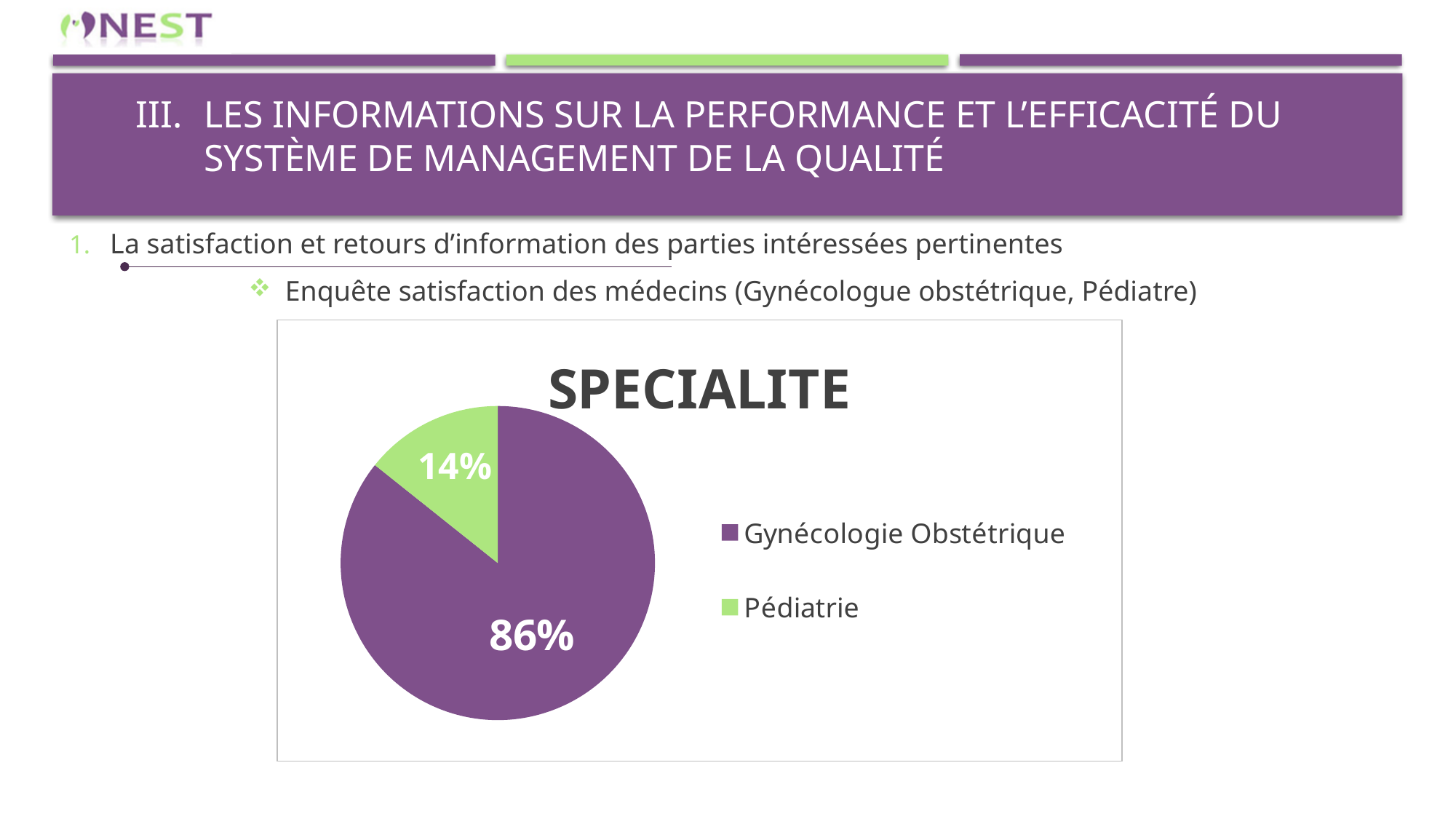
What colour is the Pédiatrie slice? green What is the difference in percentage points between the Gynécologie Obstétrique and Pédiatrie slices? 72 What kind of chart is shown on the slide? pie chart What is the title of the chart? SPECIALITE What share of the pie does Gynécologie Obstétrique represent? 86% How many entries does the legend list? 2 Which is larger, the Gynécologie Obstétrique slice or the Pédiatrie slice? Gynécologie Obstétrique Which category has the smallest slice of the pie? Pédiatrie What share of the pie does Pédiatrie represent? 14% How many categories does the pie chart show? 2 Which category has the largest slice of the pie? Gynécologie Obstétrique